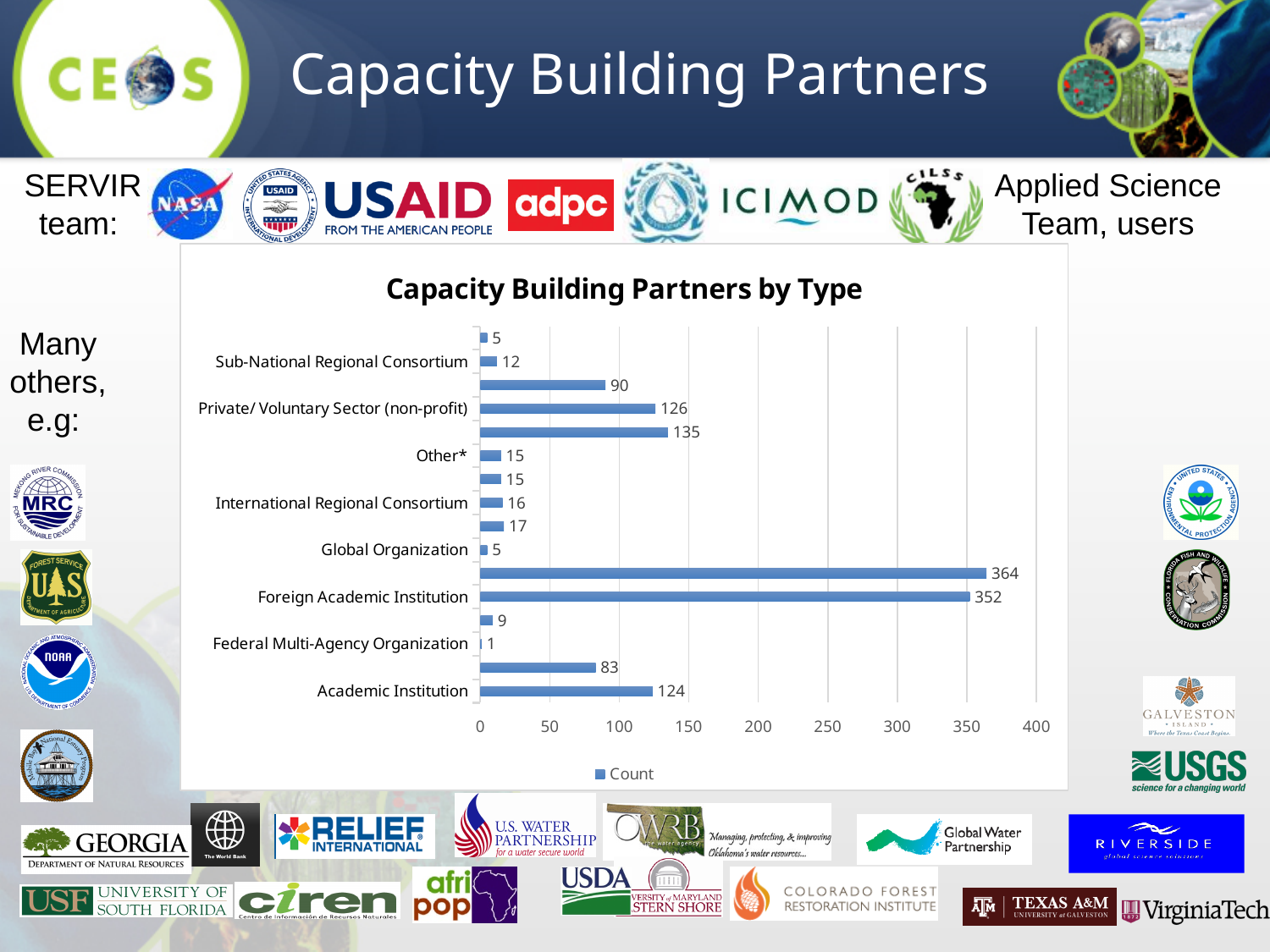
Is the value for Sub-National Regional Consortium greater or less than 50? less What kind of chart is shown on the slide? bar chart What is the difference between the values for Foreign Academic Institution and Academic Institution? 228 Which labeled category has the lowest value? Federal Multi-Agency Organization What is the value for Federal Multi-Agency Organization? 1 What is the name of the series in the chart legend? Count How many series does the chart legend list? 1 What is the value for Foreign Academic Institution? 352 What is the title of the chart? Capacity Building Partners by Type What is the value for Private/ Voluntary Sector (non-profit)? 126 What is the largest value labeled on the chart? 364 What is the value for Academic Institution? 124